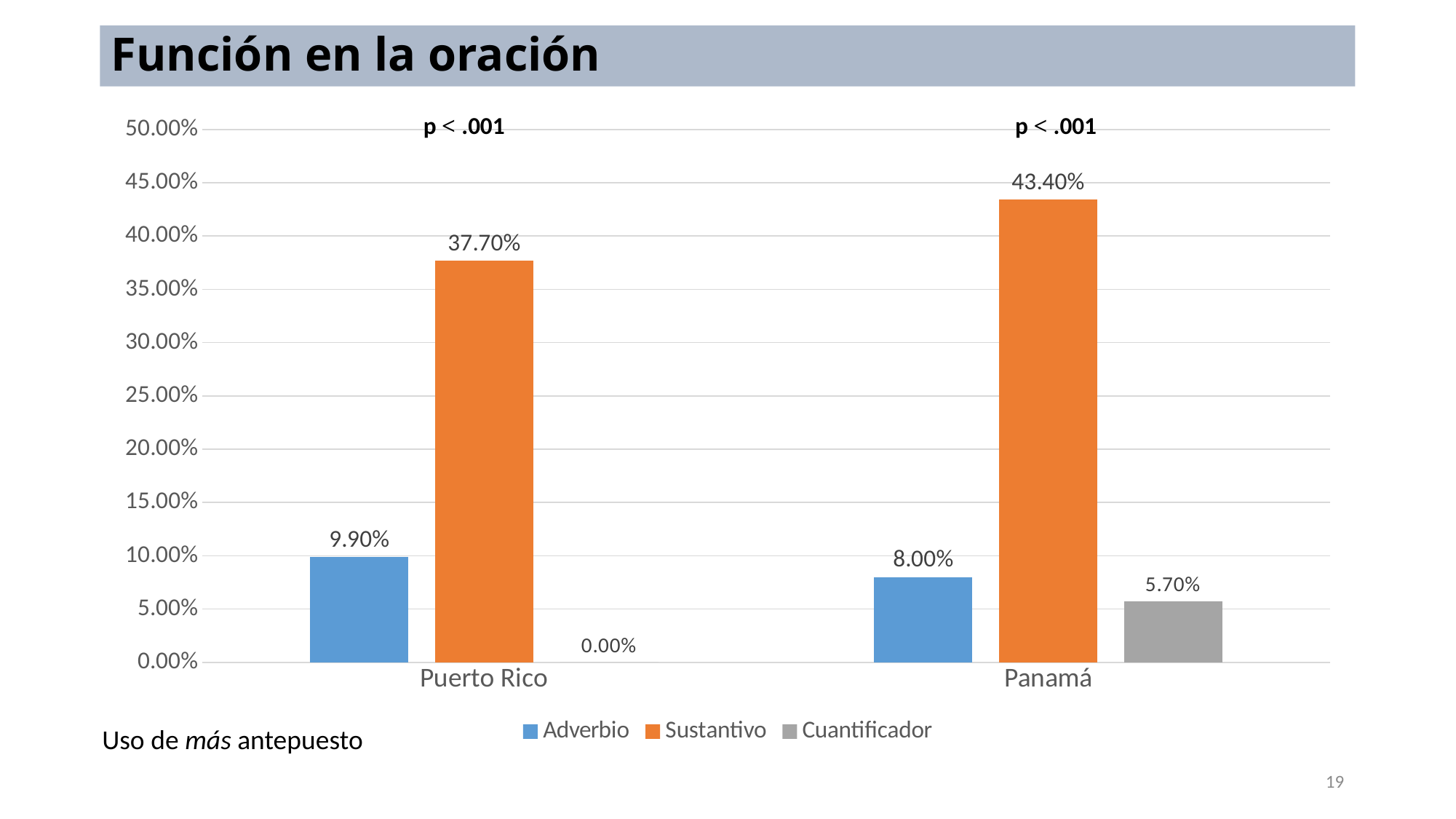
How many series does the legend list? 3 Which series has the highest value in Panamá? Sustantivo Which series has the lowest value in Puerto Rico? Cuantificador What colour are the Sustantivo bars? Orange Which is larger, the Adverbio value for Puerto Rico or for Panamá? Puerto Rico What is the value for Adverbio in Panamá? 8.00% What is the difference between the Sustantivo values for Panamá and Puerto Rico? 5.70% What is the value for Cuantificador in Puerto Rico? 0.00% What kind of chart is shown on the slide? Bar chart What is the value for Sustantivo in Puerto Rico? 37.70% How many categories are shown on the x axis? 2 What is the value for Cuantificador in Panamá? 5.70%